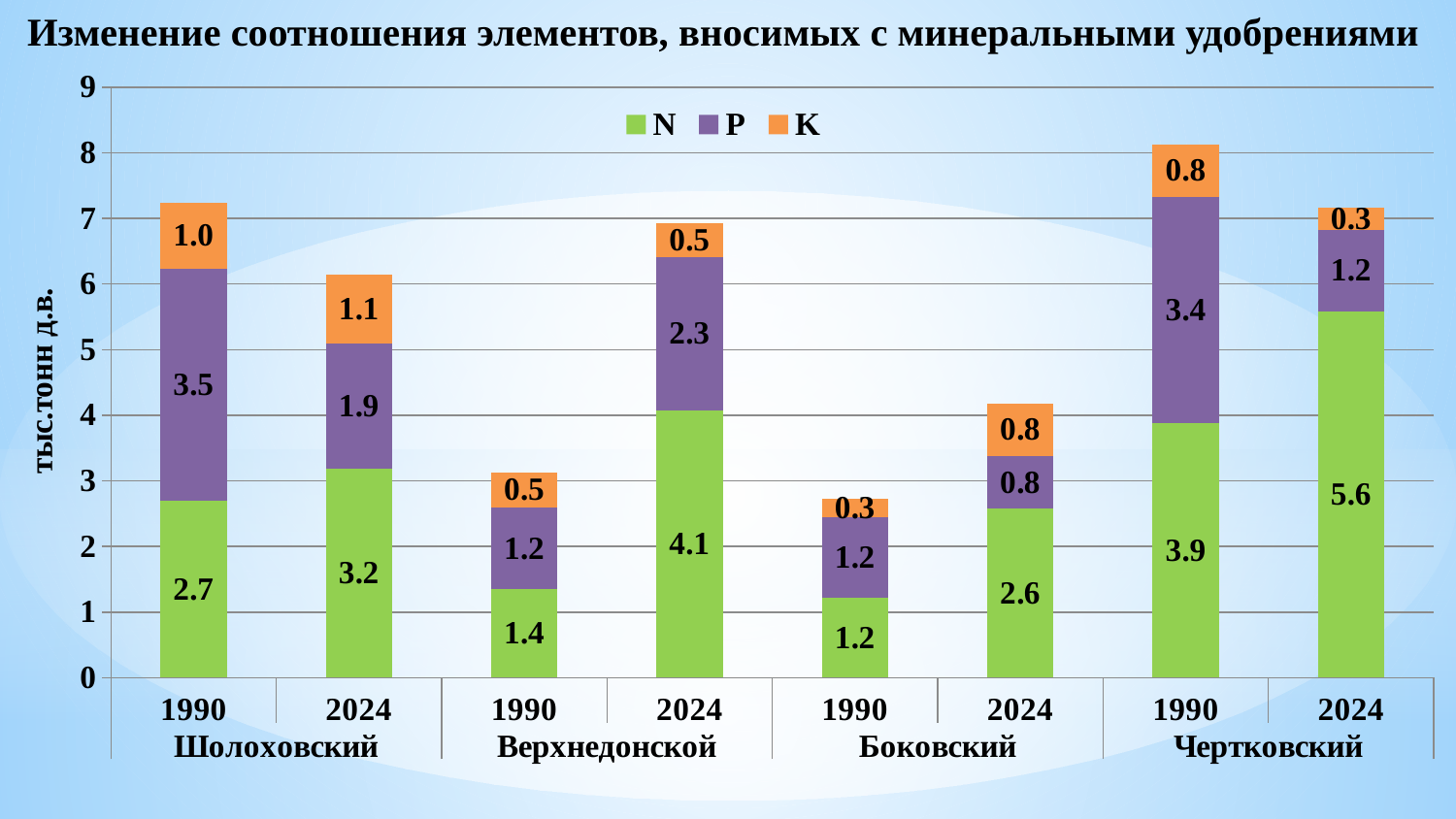
What is the difference between the N values for Верхнедонской in 2024 and 1990? 2.7 How many series does the legend list? 3 What is the value of K for Боковский in 1990? 0.3 What is the value of N for Чертковский in 2024? 5.6 Which bar has the lowest value of N? Боковский 1990 How many bars are plotted in the chart? 8 What type of chart is shown on the slide? Stacked bar chart Which bar has the highest value of N? Чертковский 2024 What is the total of the stacked bar for Боковский in 2024? 4.2 Which is larger: the P value for Шолоховский in 1990 or the P value for Чертковский in 2024? Шолоховский 1990 What is the value of P for Шолоховский in 1990? 3.5 What is the total of the stacked bar for Чертковский in 1990? 8.1